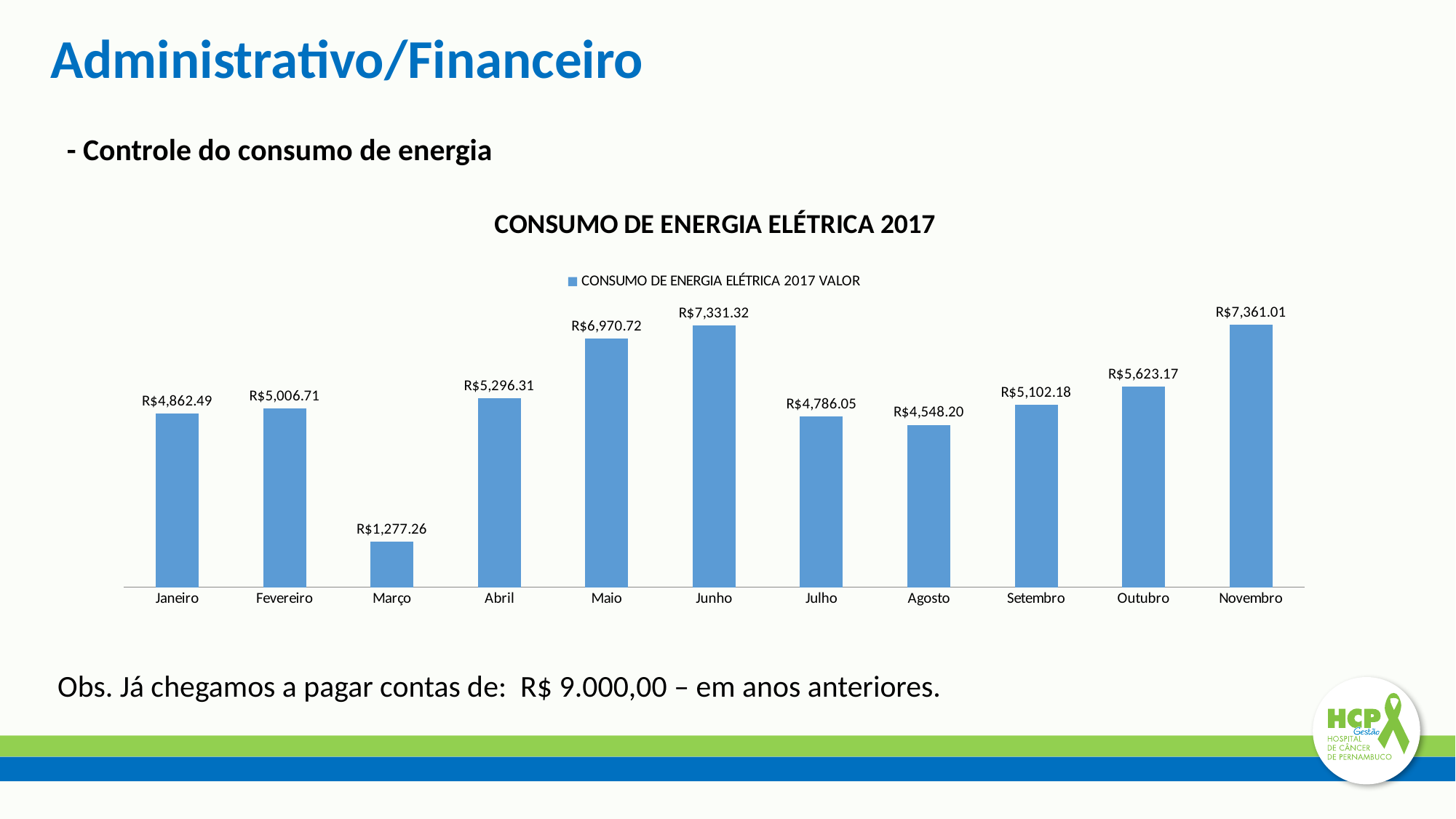
What is the value for Março? R$1,277.26 What is the value for Junho? R$7,331.32 How many series does the legend list? 1 What type of chart is shown on the slide? Bar chart What is the difference between the values for Junho and Maio? R$360.60 What is the value for Outubro? R$5,623.17 Which month has the highest value? Novembro What is the difference between the values for Fevereiro and Janeiro? R$144.22 Which is larger, the value for Maio or the value for Julho? Maio What is the title of the chart? CONSUMO DE ENERGIA ELÉTRICA 2017 How many months are shown on the x axis of the chart? 11 Which month has the lowest value? Março